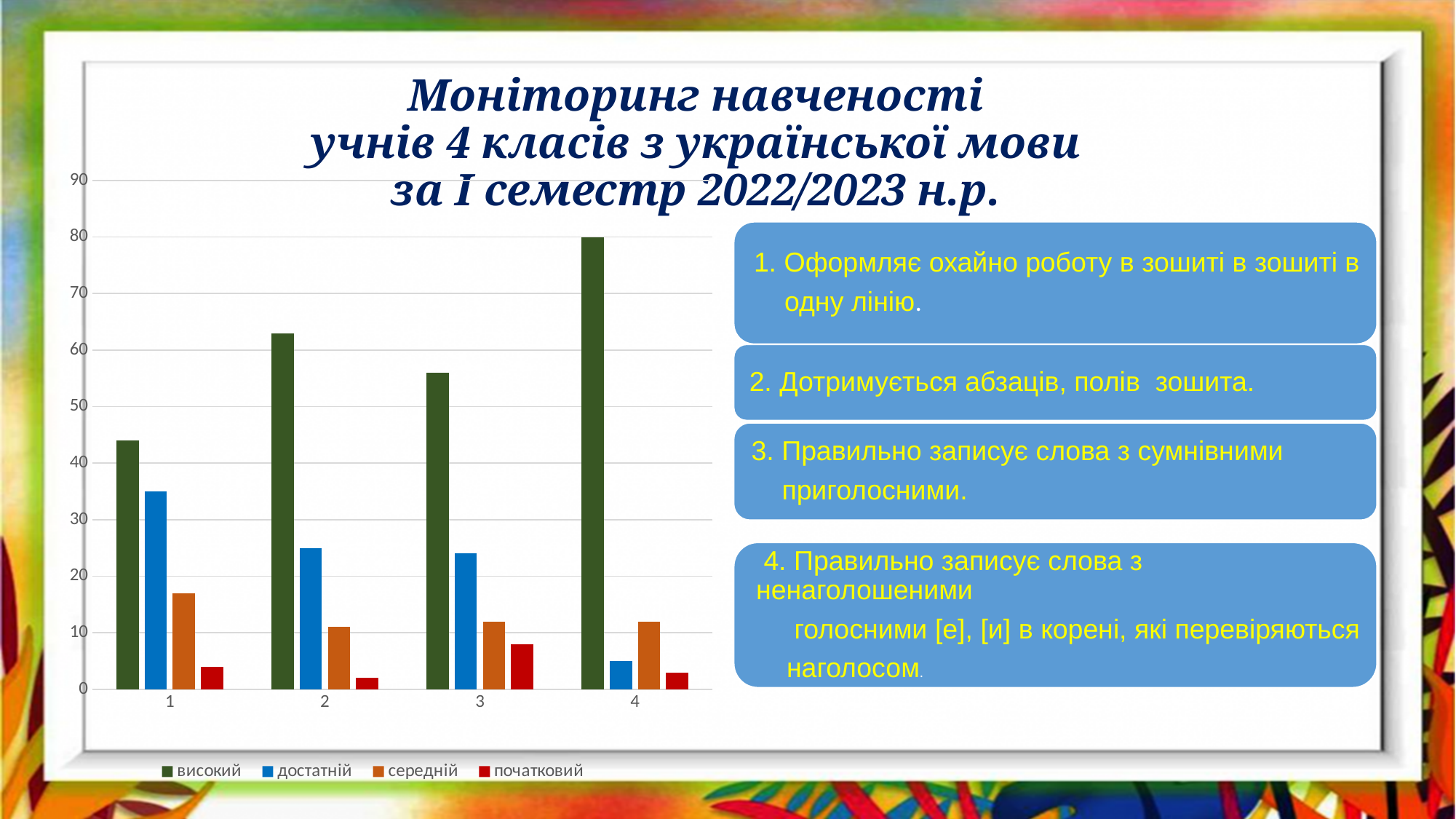
How many categories are shown on the x axis? 4 How many series does the legend list? 4 For which category is the високий series highest? 4 For which category is the початковий series highest? 3 Is the value of the високий series for category 2 greater or less than 60? greater What kind of chart is shown on the slide? bar chart What is the value of the високий series for category 4? 80 For which category is the високий series lowest? 1 Is the value of the достатній series for category 1 greater or less than 30? greater Which series is shown in red in the legend? початковий Is the value of the достатній series for category 4 greater or less than 10? less Which is larger for category 3: the достатній series or the середній series? достатній